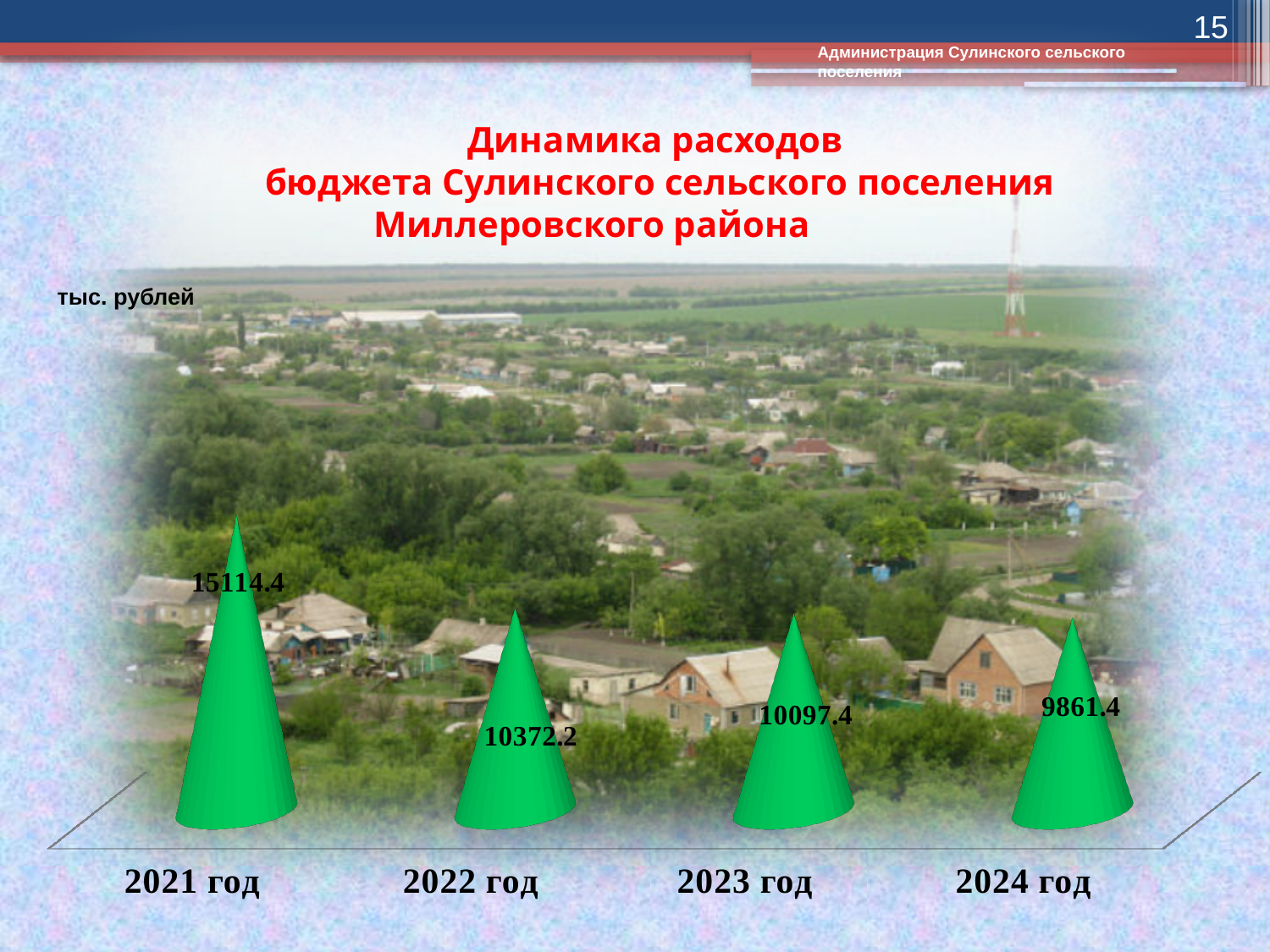
In what units are the values on the chart given? тыс. рублей Which is larger, the value for 2022 год or the value for 2023 год? 2022 год What is the value for 2021 год? 15114.4 What is the value for 2023 год? 10097.4 How many years are shown on the chart? 4 Do the values rise or fall from 2021 год to 2024 год? fall Which year has the lowest value? 2024 год What is the value for 2024 год? 9861.4 What is the difference between the values for 2021 год and 2022 год? 4742.2 Which year has the highest value? 2021 год What is the difference between the values for 2021 год and 2024 год? 5253 What is the value for 2022 год? 10372.2